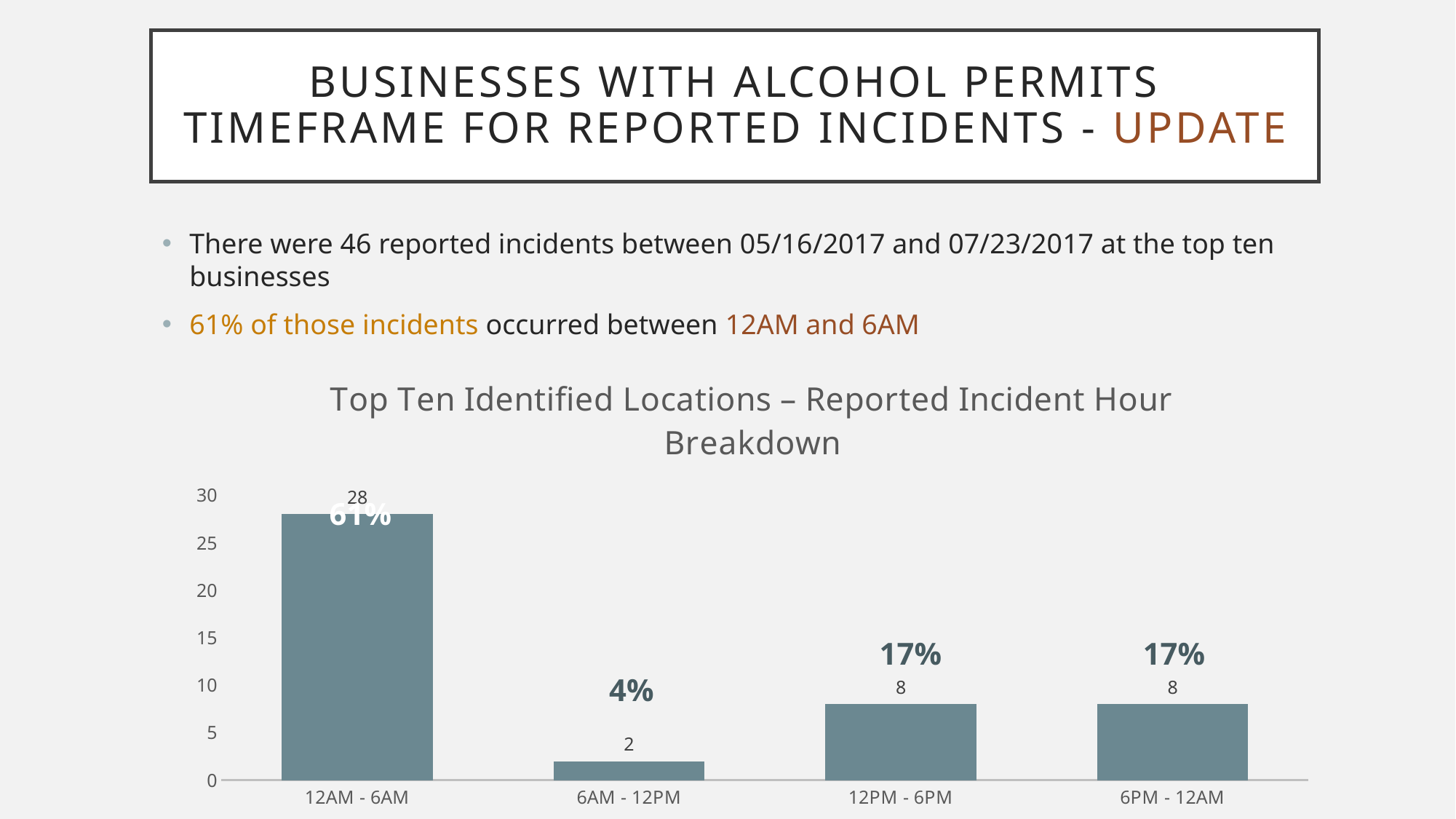
Which has more reported incidents, 6AM - 12PM or 12PM - 6PM? 12PM - 6PM What is the number of reported incidents for 12PM - 6PM? 8 What is the number of reported incidents for 12AM - 6AM? 28 What is the difference in reported incidents between 12AM - 6AM and 6PM - 12AM? 20 What type of chart is shown on the slide? bar chart Which time period has the lowest number of reported incidents? 6AM - 12PM Which time period has the highest number of reported incidents? 12AM - 6AM Is the value for 12AM - 6AM greater or less than 25? greater How many time periods are shown on the x axis? 4 What percentage label is shown above the 6AM - 12PM bar? 4% What is the number of reported incidents for 6AM - 12PM? 2 What is the title of the chart? Top Ten Identified Locations – Reported Incident Hour Breakdown